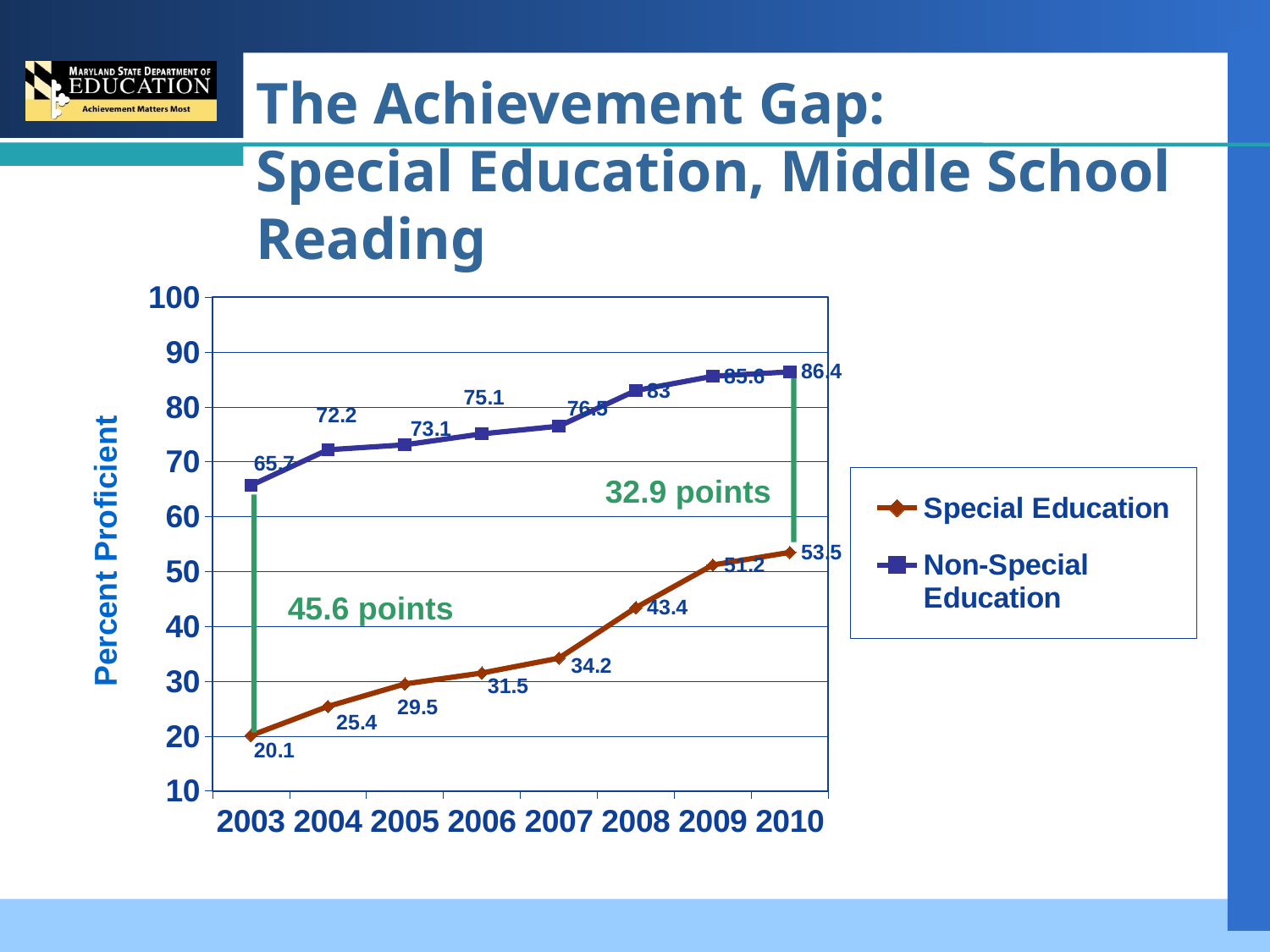
What is the Non-Special Education percent proficient value for 2010? 86.4 What is the difference between the Non-Special Education and Special Education values in 2010? 32.9 What is the Special Education percent proficient value for 2003? 20.1 What kind of chart is shown on the slide? Line chart Which series has the larger value in 2007, Special Education or Non-Special Education? Non-Special Education What is the Special Education value for 2008? 43.4 In which year is the Non-Special Education value lowest? 2003 What is the Non-Special Education value for 2006? 75.1 What is the difference between the Special Education values for 2009 and 2008? 7.8 Does the Special Education line rise or fall from 2003 to 2010? Rise How many series does the legend list? 2 In which year is the Special Education value highest? 2010